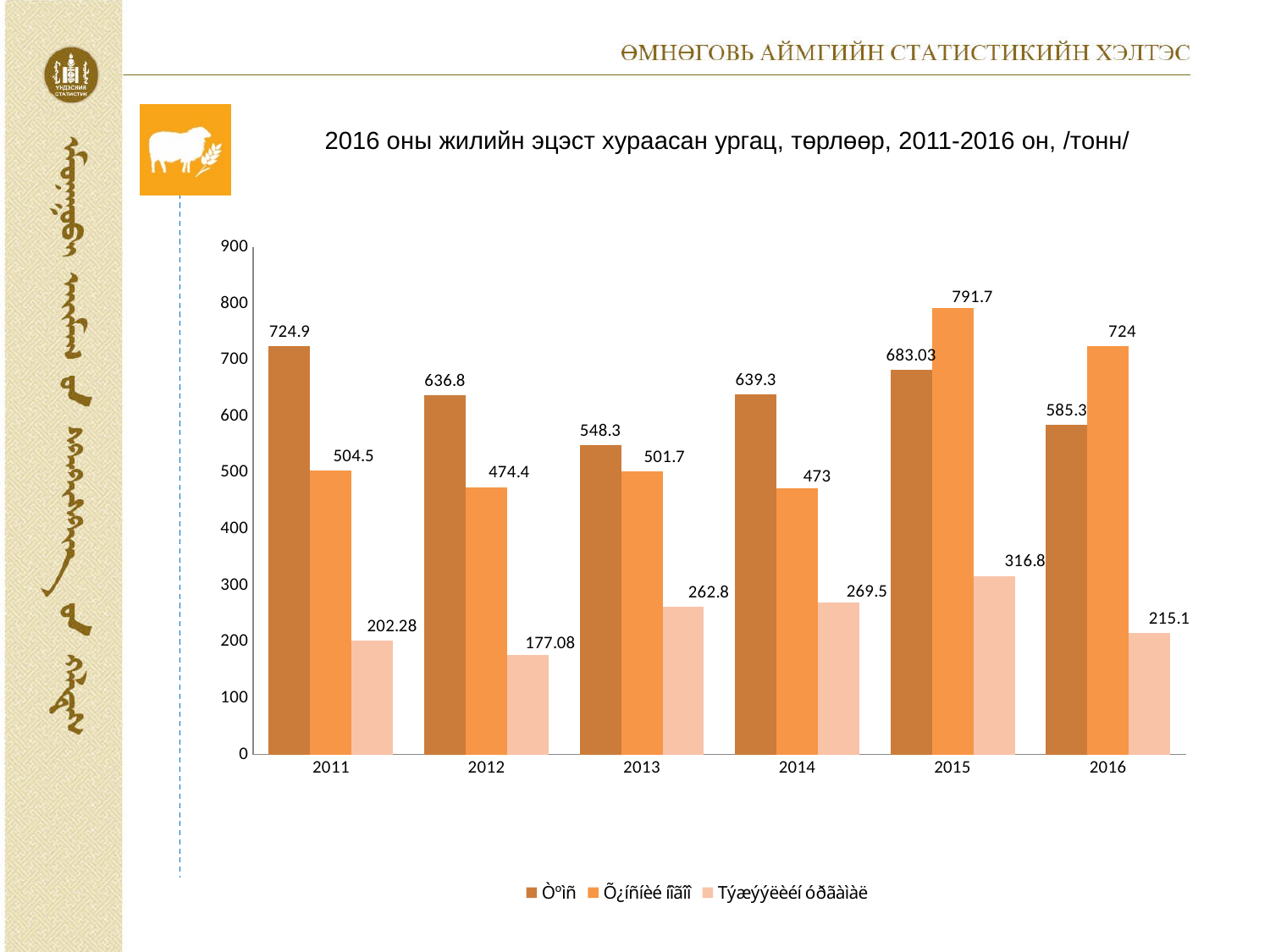
Does the dark orange (first) series rise or fall from 2011 to 2013? fall How many series does the legend list? 3 What is the value of the orange (second) bar for 2015? 791.7 Which is larger in 2015, the dark orange (first) bar or the orange (second) bar? the orange (second) bar In which year is the light peach (third) bar lowest? 2012 What is the difference between the dark orange bar and the orange bar for 2016? 138.7 How many years are shown on the x axis of the chart? 6 What is the value of the dark orange (first) bar for 2011? 724.9 In which year is the dark orange (first) bar highest? 2011 Is the value of the light peach (third) bar for 2015 greater or less than 300? greater What type of chart is shown on the slide? bar chart What is the value of the light peach (third) bar for 2012? 177.08